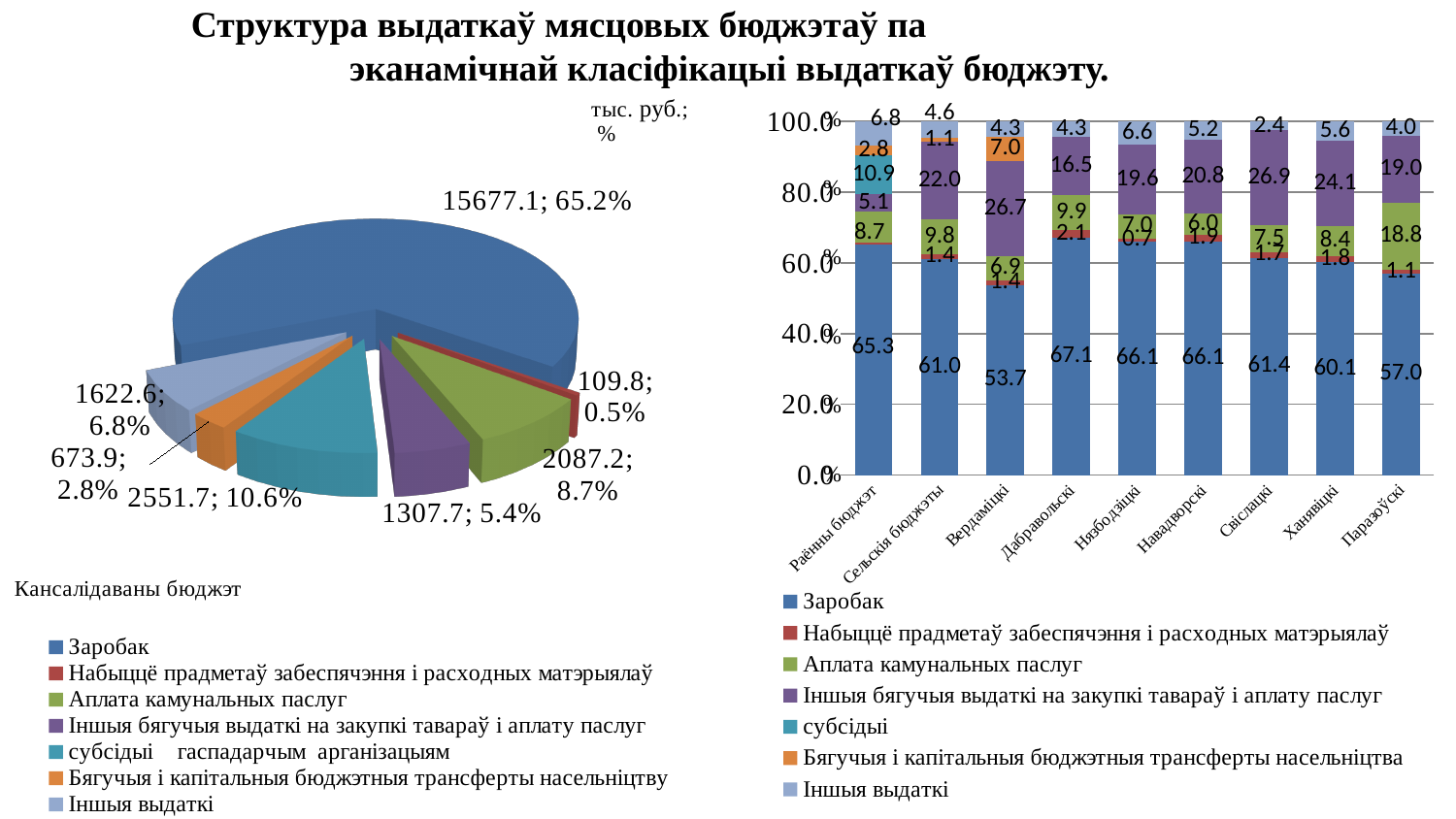
On the pie chart (Кансалідаваны бюджэт), how many slices are there? 7 On the stacked bar chart, which is larger: the Заробак value for Раённы бюджэт or for Сельскія бюджэты? Раённы бюджэт On the stacked bar chart, which category has the highest value for Заробак? Дабравольскі On the stacked bar chart, what is the difference between the Заробак values for Дабравольскі (67.1) and Паразоўскі (57.0)? 10.1 On the stacked bar chart, what is the value of Заробак for Вердаміцкі? 53.7 On the pie chart (Кансалідаваны бюджэт), what share does Аплата камунальных паслуг have? 8.7% What kind of chart is the chart on the right side of the slide? Stacked bar chart On the stacked bar chart, how many series does the legend list? 7 On the pie chart (Кансалідаваны бюджэт), which category has the smallest slice? Набыццё прадметаў забеспячэння і расходных матэрыялаў On the pie chart (Кансалідаваны бюджэт), what value and share are shown for Заробак? 15677.1; 65.2% On the pie chart (Кансалідаваны бюджэт), what is the difference between the value for субсідыі (2551.7) and the value for Аплата камунальных паслуг (2087.2)? 464.5 On the stacked bar chart, how many categories are shown on the x axis? 9